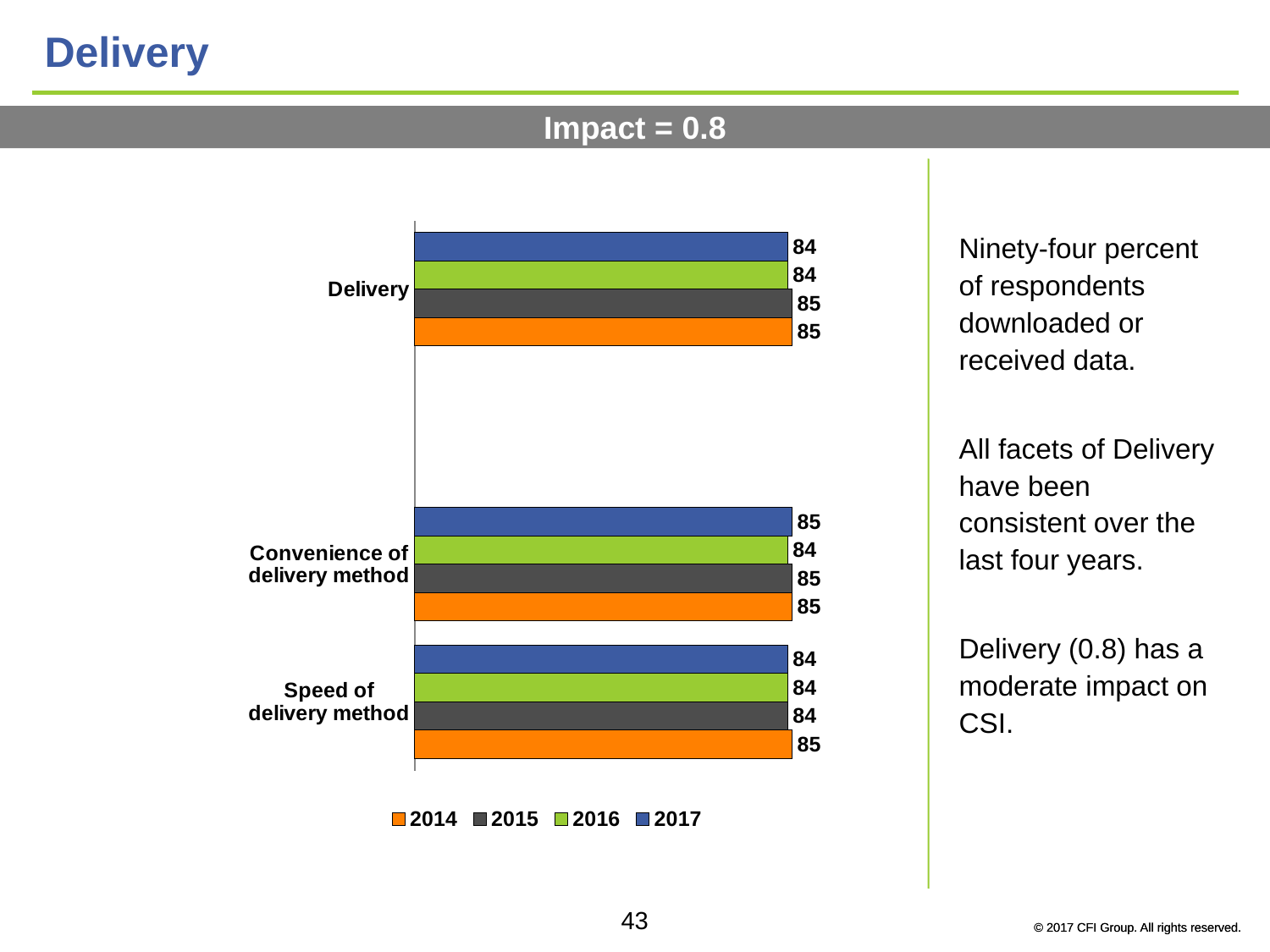
What impact value is shown in the banner above the chart? 0.8 Which year is represented by the orange bars in the legend? 2014 What is the difference between the 2014 and 2017 values for Speed of delivery method? 1 Which is larger for Convenience of delivery method, the 2016 value or the 2017 value? 2017 How many series does the legend list? 4 What kind of chart is shown on the slide? Bar chart What is the 2017 value for Delivery? 84 What is the 2016 value for Convenience of delivery method? 84 How many categories are shown on the chart? 3 What is the 2014 value for Speed of delivery method? 85 What is the 2015 value for Delivery? 85 What is the 2017 value for Convenience of delivery method? 85